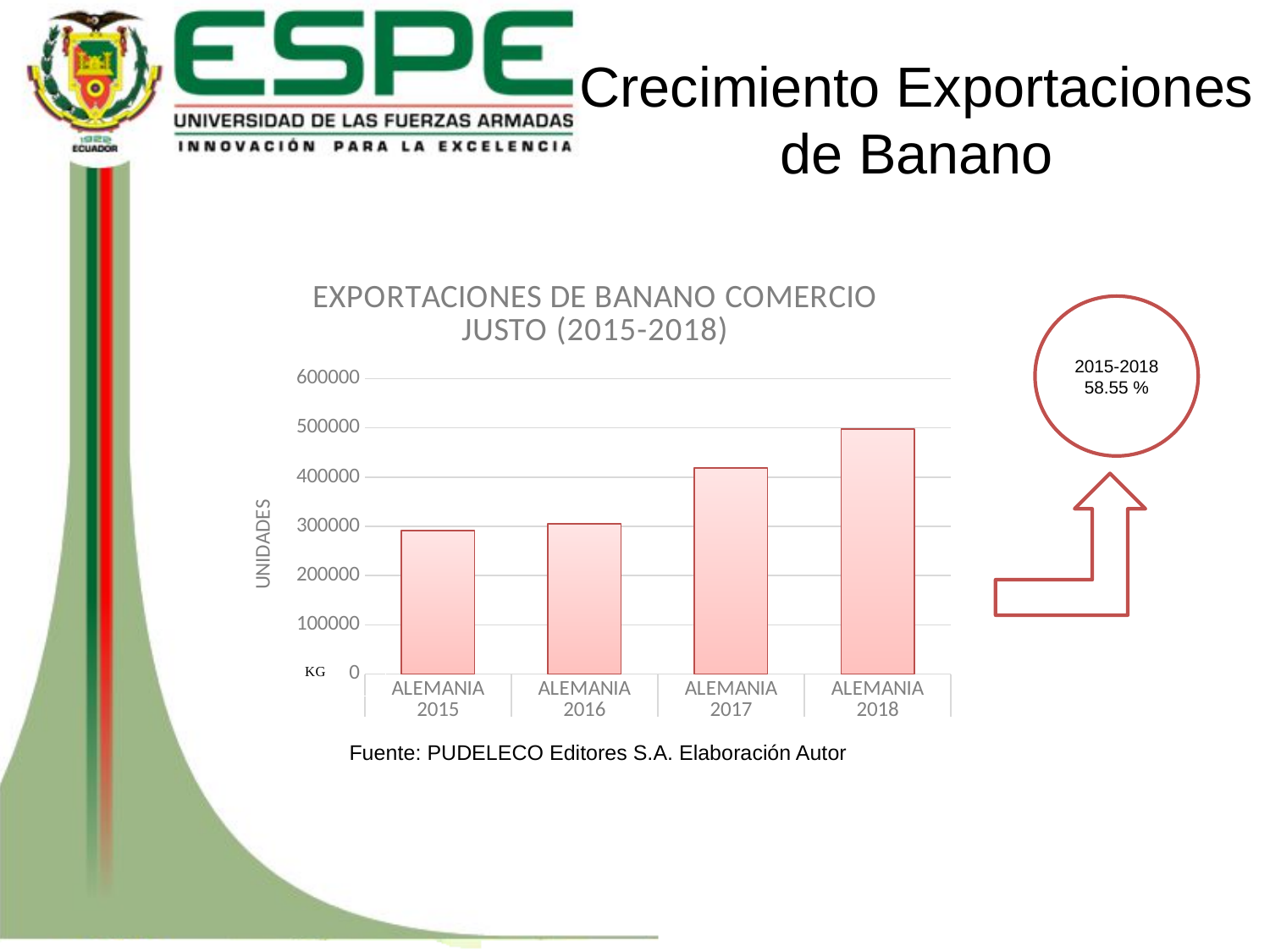
What is the title of the chart? EXPORTACIONES DE BANANO COMERCIO JUSTO (2015-2018) How many bars are plotted in the chart? 4 What kind of chart is shown on the slide? bar chart Is the value for ALEMANIA 2018 greater or less than 400000? greater Which category has the highest value in the chart? ALEMANIA 2018 Which is larger, the value for ALEMANIA 2018 or ALEMANIA 2015? ALEMANIA 2018 Is the value for ALEMANIA 2015 greater or less than 200000? greater Do the values rise or fall from ALEMANIA 2015 to ALEMANIA 2018? rise Is the value for ALEMANIA 2017 greater or less than 400000? greater What label is shown on the vertical axis of the chart? UNIDADES Which is larger, the value for ALEMANIA 2017 or ALEMANIA 2016? ALEMANIA 2017